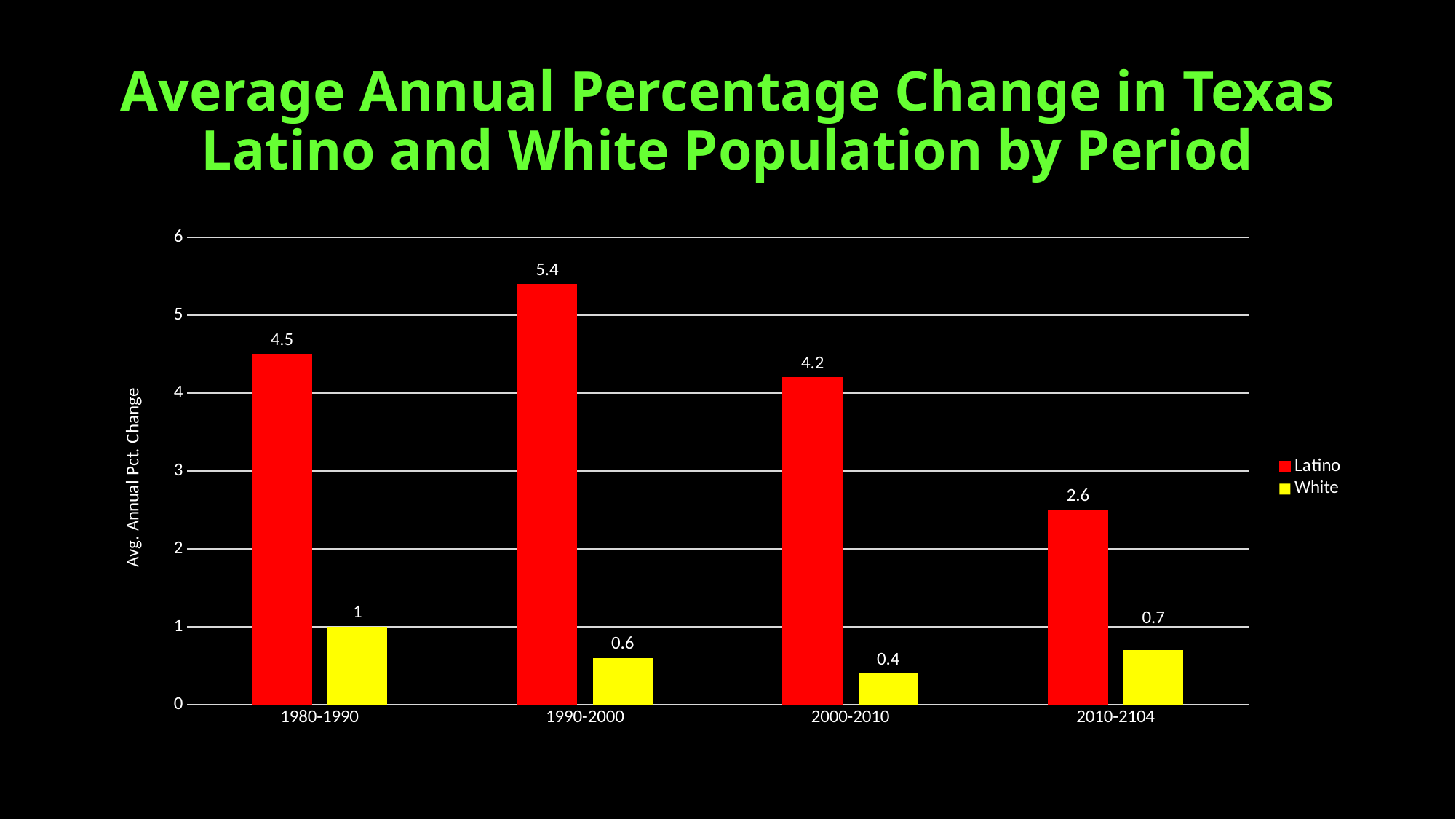
How many series does the legend list? 2 Which period has the lowest White value? 2000-2010 What kind of chart is shown on the slide? bar chart What is the difference between the Latino and White values for 2010-2104? 1.9 Is the Latino value for 2010-2104 greater or less than 3? less What is the Latino value for 1990-2000? 5.4 What is the White value for 2000-2010? 0.4 What is the White value for 1980-1990? 1 How many periods are shown on the x axis? 4 Which period has the highest Latino value? 1990-2000 Which is larger, the Latino value for 1980-1990 or the Latino value for 2000-2010? 1980-1990 What is the label of the vertical axis? Avg. Annual Pct. Change